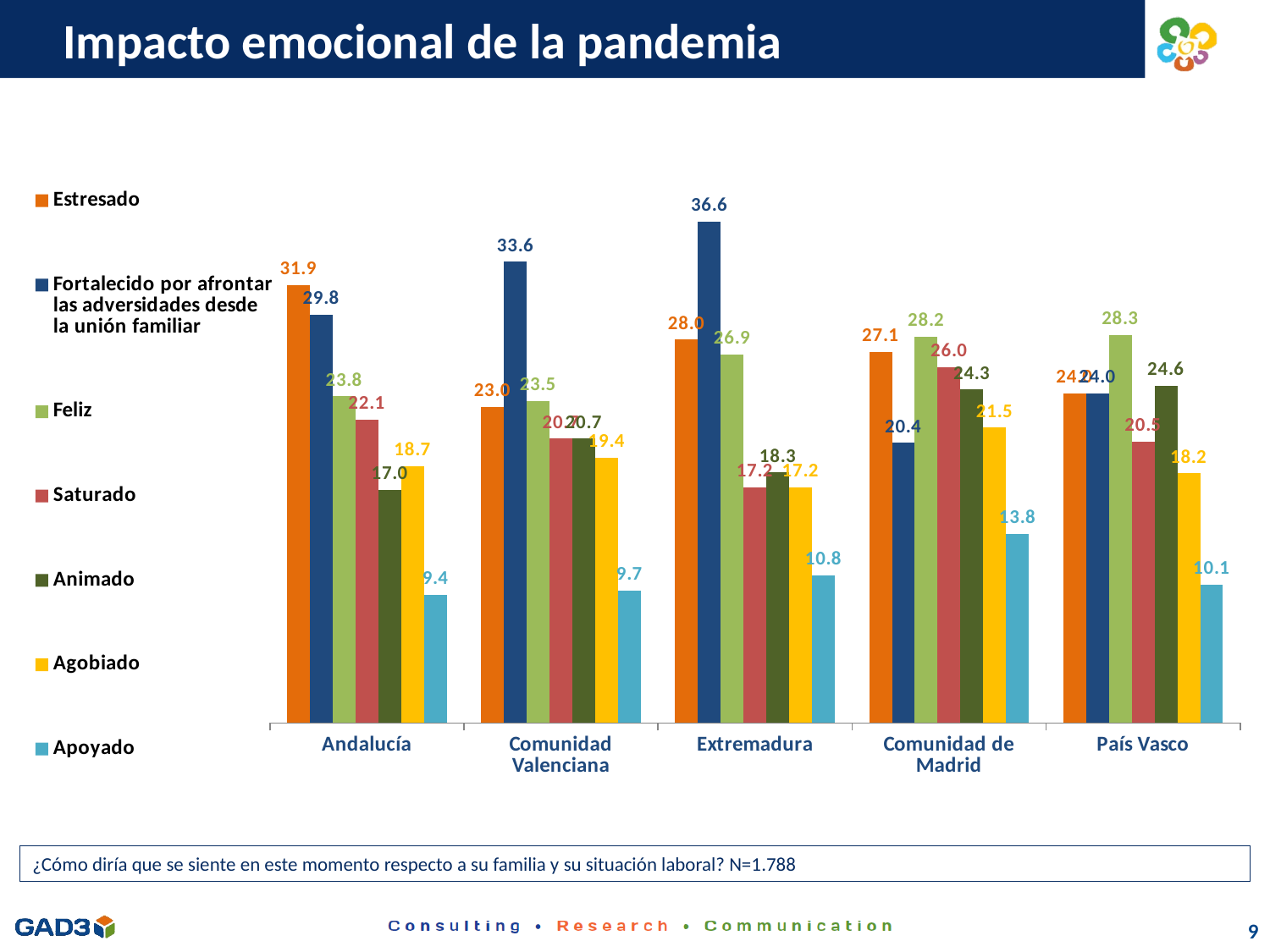
What is the value for Apoyado in Comunidad de Madrid? 13.8 What kind of chart is shown on the slide? bar chart How many regions are shown on the x axis? 5 Which region has the highest value for Estresado? Andalucía How many series does the legend list? 7 What is the value for Fortalecido por afrontar las adversidades desde la unión familiar in Extremadura? 36.6 Which region has the highest value for Fortalecido por afrontar las adversidades desde la unión familiar? Extremadura What is the title of the slide? Impacto emocional de la pandemia What is the value for Agobiado in Andalucía? 18.7 What is the difference between Estresado and Fortalecido por afrontar las adversidades desde la unión familiar in Andalucía? 2.1 In Comunidad de Madrid, which is larger, Feliz or Saturado? Feliz Which region has the lowest value for Fortalecido por afrontar las adversidades desde la unión familiar? Comunidad de Madrid